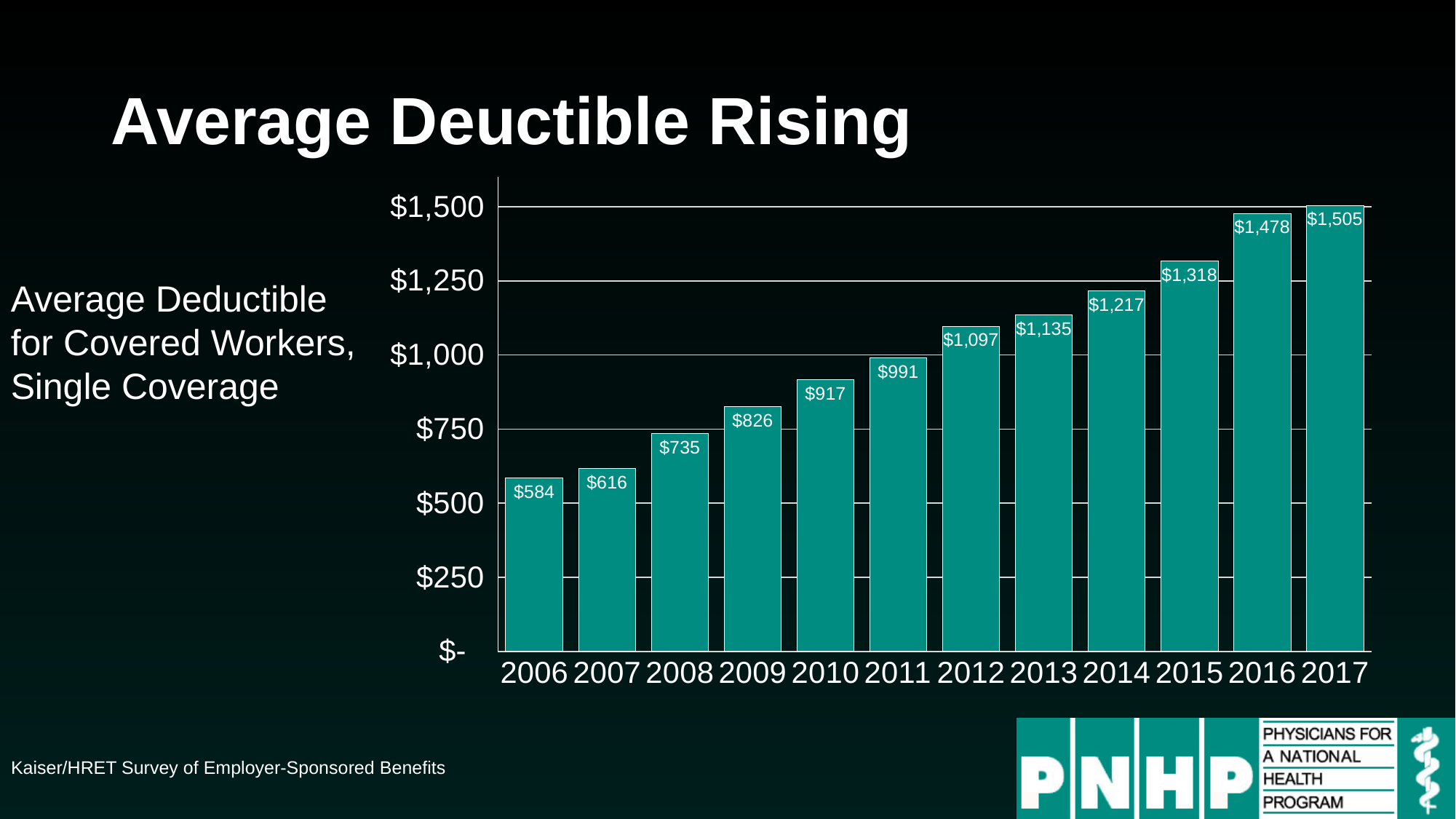
What is the difference between the average deductible in 2017 and in 2006? $921 Is the value for 2014 greater or less than $1,000? greater What kind of chart is shown on the slide? Bar chart What is the average deductible shown for 2006? $584 What is the difference between the average deductible in 2010 and in 2009? $91 What is the average deductible shown for 2012? $1,097 Do the values rise or fall from 2006 to 2017? Rise How many years are shown on the x axis? 12 Which year has a larger average deductible, 2013 or 2011? 2013 What is the average deductible shown for 2017? $1,505 Which year has the highest average deductible? 2017 Which year has the lowest average deductible? 2006